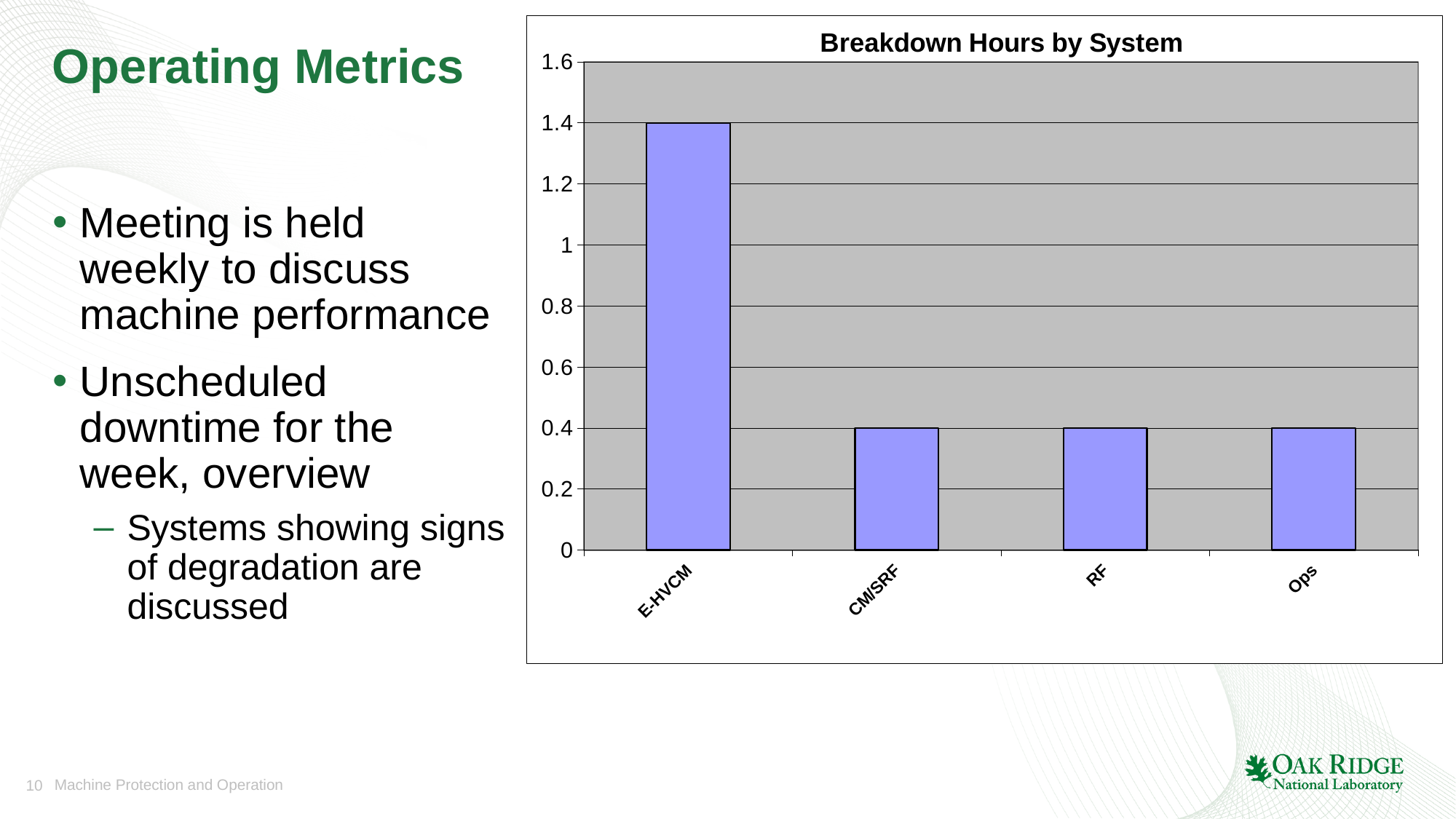
Which is larger, the value for E-HVCM or the value for Ops? E-HVCM How many systems are shown on the x axis of the chart? 4 What is the value for CM/SRF in the Breakdown Hours by System chart? 0.4 Which system has the highest breakdown hours in the chart? E-HVCM What is the title of the chart on the slide? Breakdown Hours by System What is the value for E-HVCM in the Breakdown Hours by System chart? 1.4 What is the value for RF in the Breakdown Hours by System chart? 0.4 Is the value for CM/SRF greater or less than 0.6? less What is the difference between the values for E-HVCM and RF? 1 Is the value for E-HVCM greater or less than 1? greater What kind of chart is shown on the slide? Bar chart What is the value for Ops in the Breakdown Hours by System chart? 0.4